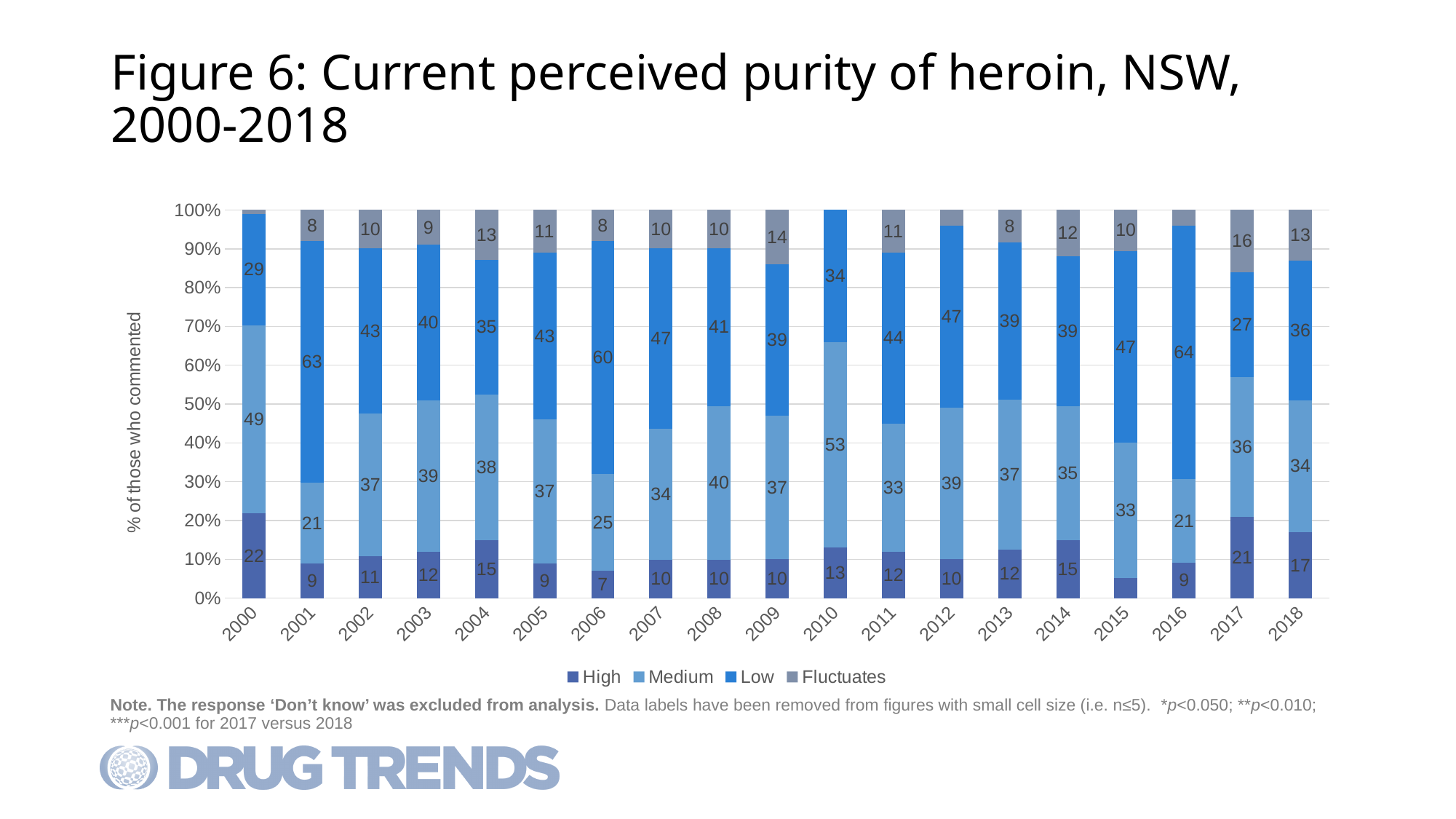
What kind of chart is shown on the slide? Stacked bar chart In which year is the Low value highest? 2016 What is the value for Low in 2016? 64 How many years are shown on the x axis? 19 What is the label of the y axis? % of those who commented Among the years with a printed High label, which year has the lowest High value? 2006 Which is larger, the Medium value in 2000 or the Medium value in 2001? 2000 How many series does the legend list? 4 What is the difference between the Low values for 2016 and 2018? 28 What is the value for High in 2017? 21 What is the value for Medium in 2010? 53 What is the value for Fluctuates in 2009? 14